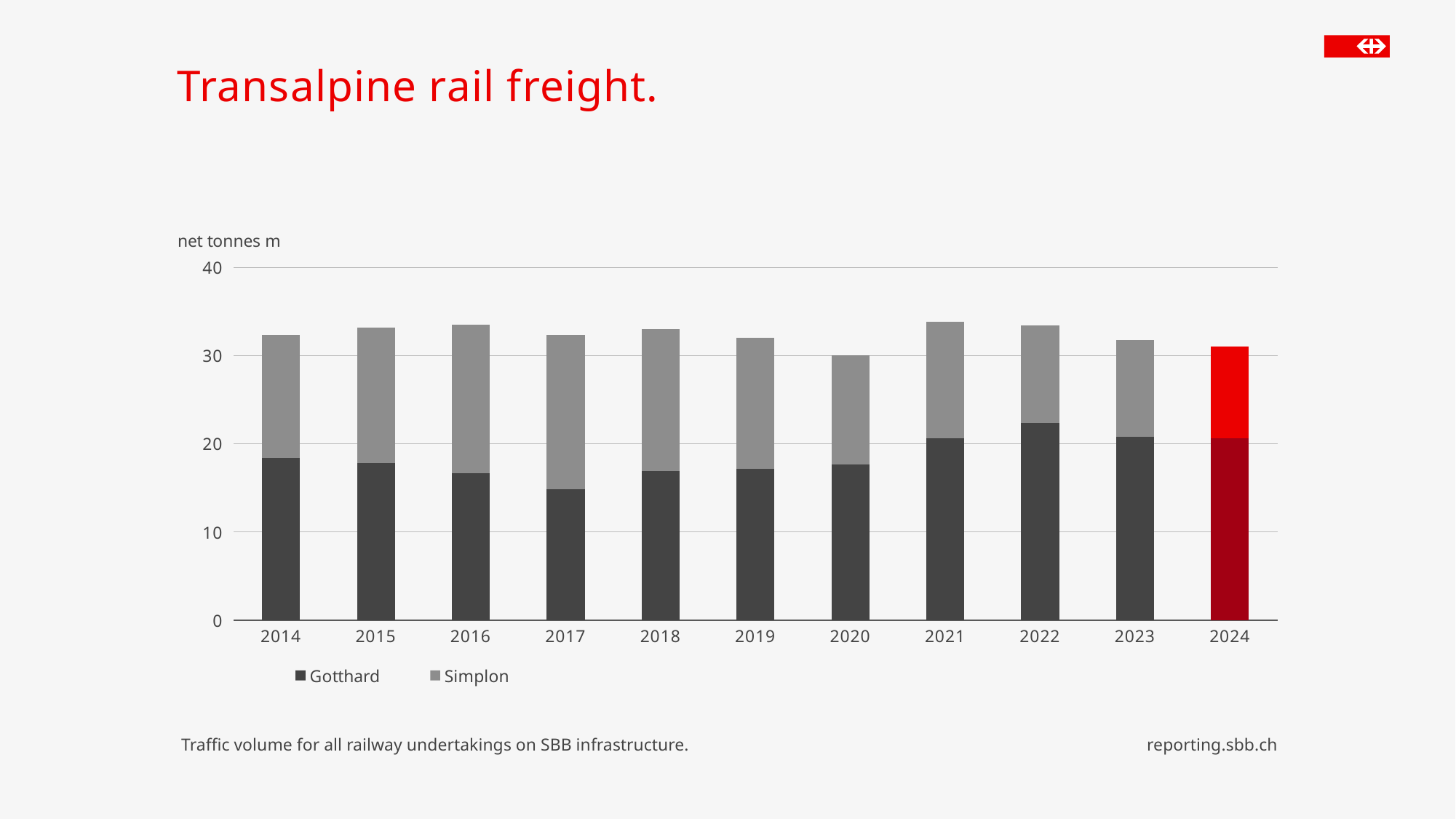
Which is larger, the Gotthard value for 2021 or for 2014? 2021 Which series are listed in the legend? Gotthard and Simplon Is the Gotthard value for 2022 greater or less than 20? greater Is the Gotthard value for 2017 greater or less than 20? less How many series does the legend list? 2 How many years are shown on the x axis of the chart? 11 In which year is the total stacked bar (Gotthard plus Simplon) lowest? 2020 In which year is the Gotthard value highest? 2022 Is the total stacked bar for 2014 greater or less than 30? greater What kind of chart is shown on the slide? Stacked bar chart In which year is the Gotthard value lowest? 2017 What is the unit label shown above the y axis? net tonnes m